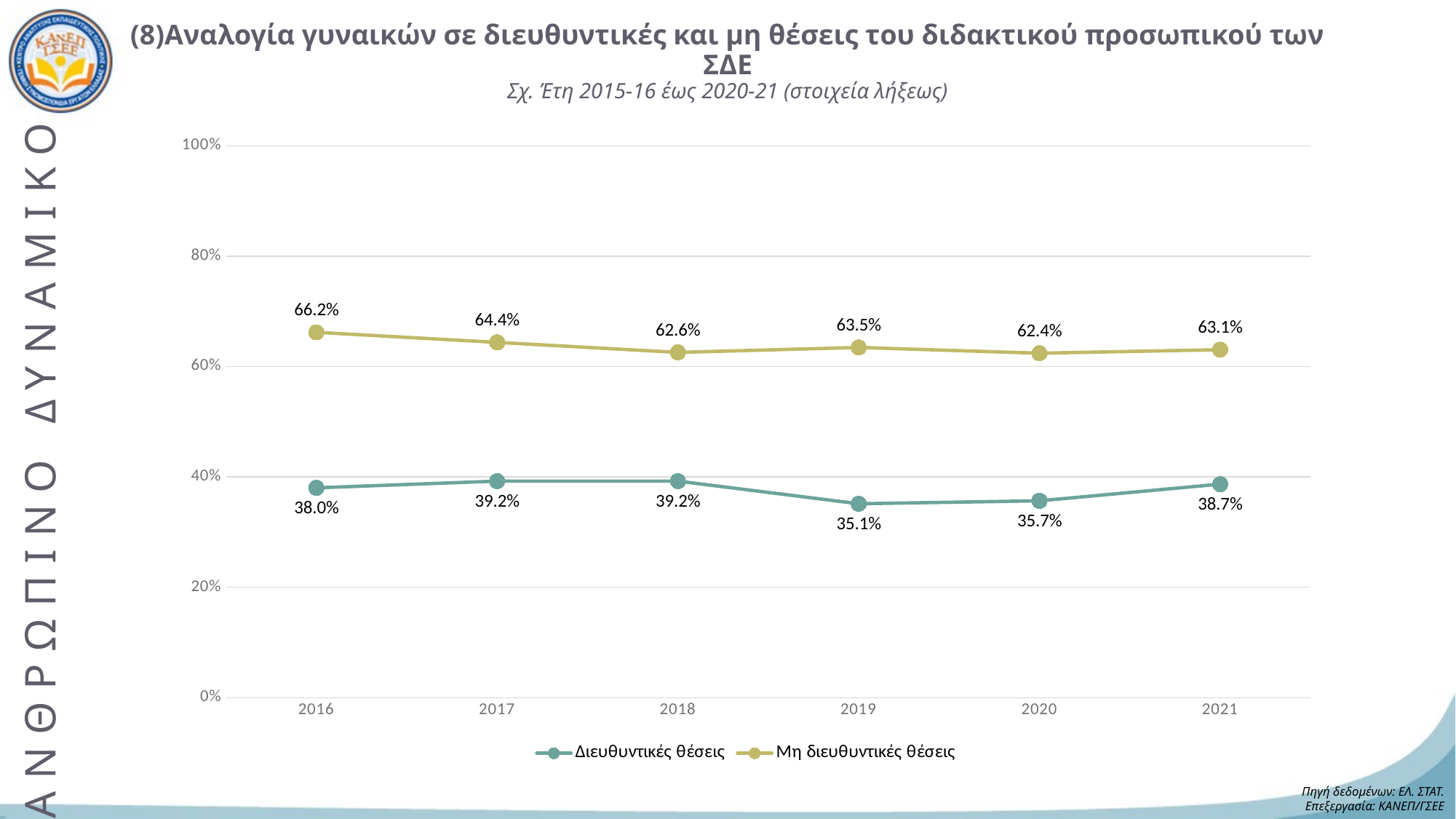
Which is larger for Διευθυντικές θέσεις: the value in 2020 or the value in 2021? 2021 Does the value for Μη διευθυντικές θέσεις rise or fall from 2016 to 2018? fall What is the value for Μη διευθυντικές θέσεις in 2021? 63.1% What kind of chart is shown on the slide? line chart In which year is the value for Διευθυντικές θέσεις lowest? 2019 Is the value for Μη διευθυντικές θέσεις in 2018 greater or less than 60%? greater How many series does the legend list? 2 In which year is the value for Μη διευθυντικές θέσεις highest? 2016 How many years are shown on the x axis? 6 What is the value for Μη διευθυντικές θέσεις in 2016? 66.2% What is the value for Διευθυντικές θέσεις in 2019? 35.1% What is the difference between the Μη διευθυντικές θέσεις and Διευθυντικές θέσεις values in 2016? 28.2%